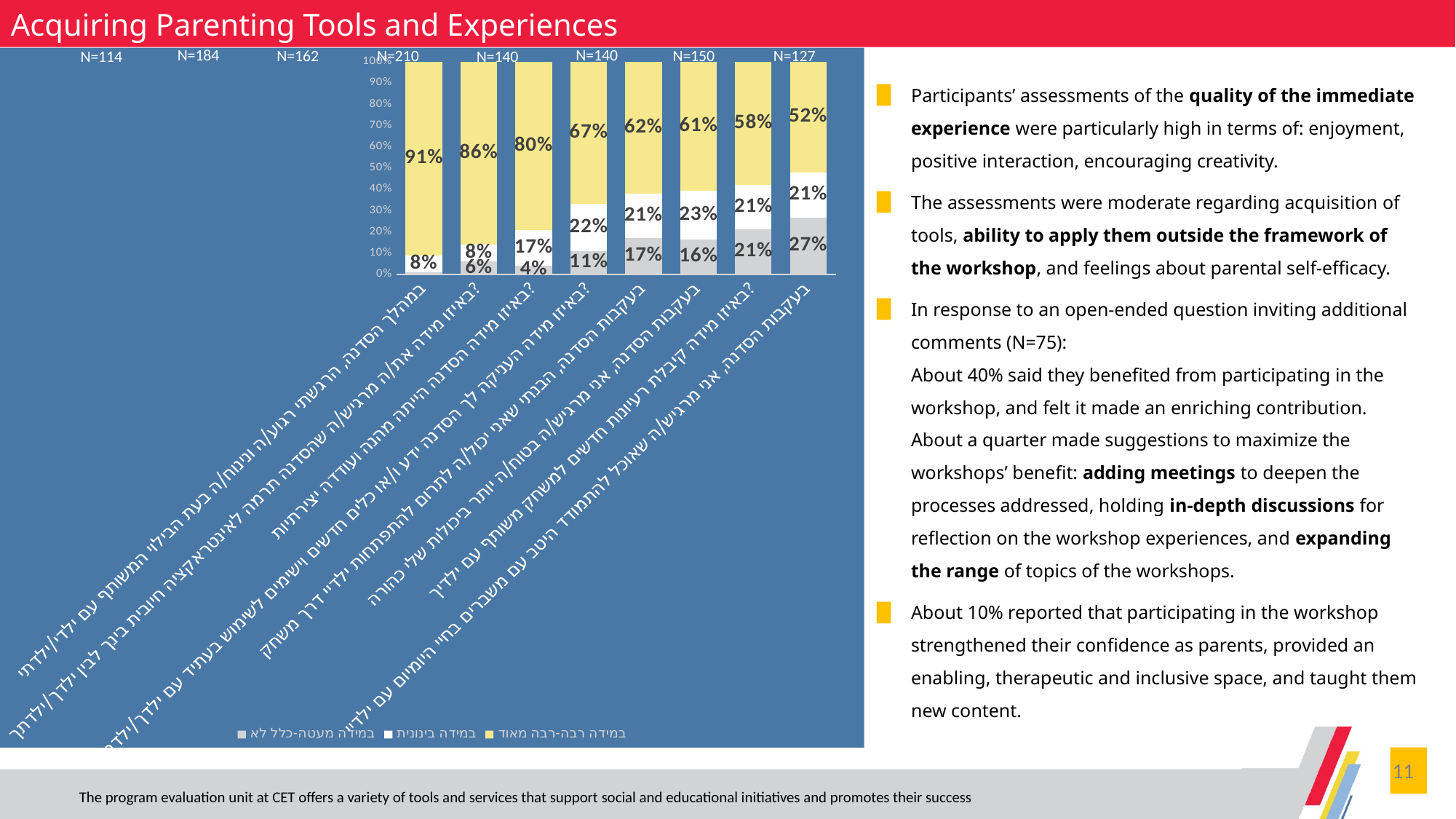
What is the value of the yellow (top) segment of the first bar from the left? 91% How many series does the chart's legend list? 3 What is the value of the gray (bottom) segment of the last bar on the right? 27% What is the difference between the yellow segment values of the first bar (91%) and the last bar (52%)? 39 percentage points What is the value of the yellow (top) segment of the last bar on the right? 52% What is the value of the white (middle) segment of the third bar from the left? 17% Which bar has the lowest yellow (top) segment value? The last bar on the right (52%) What kind of chart is shown on the slide? Stacked bar chart Is the gray (bottom) segment of the fourth bar from the left (11%) larger or smaller than the gray segment of the fifth bar (17%)? Smaller Which bar has the highest yellow (top) segment value? The first bar from the left (91%) Do the yellow (top) segment values rise or fall moving from left to right across the bars? Fall How many bars (categories) does the chart contain? 8